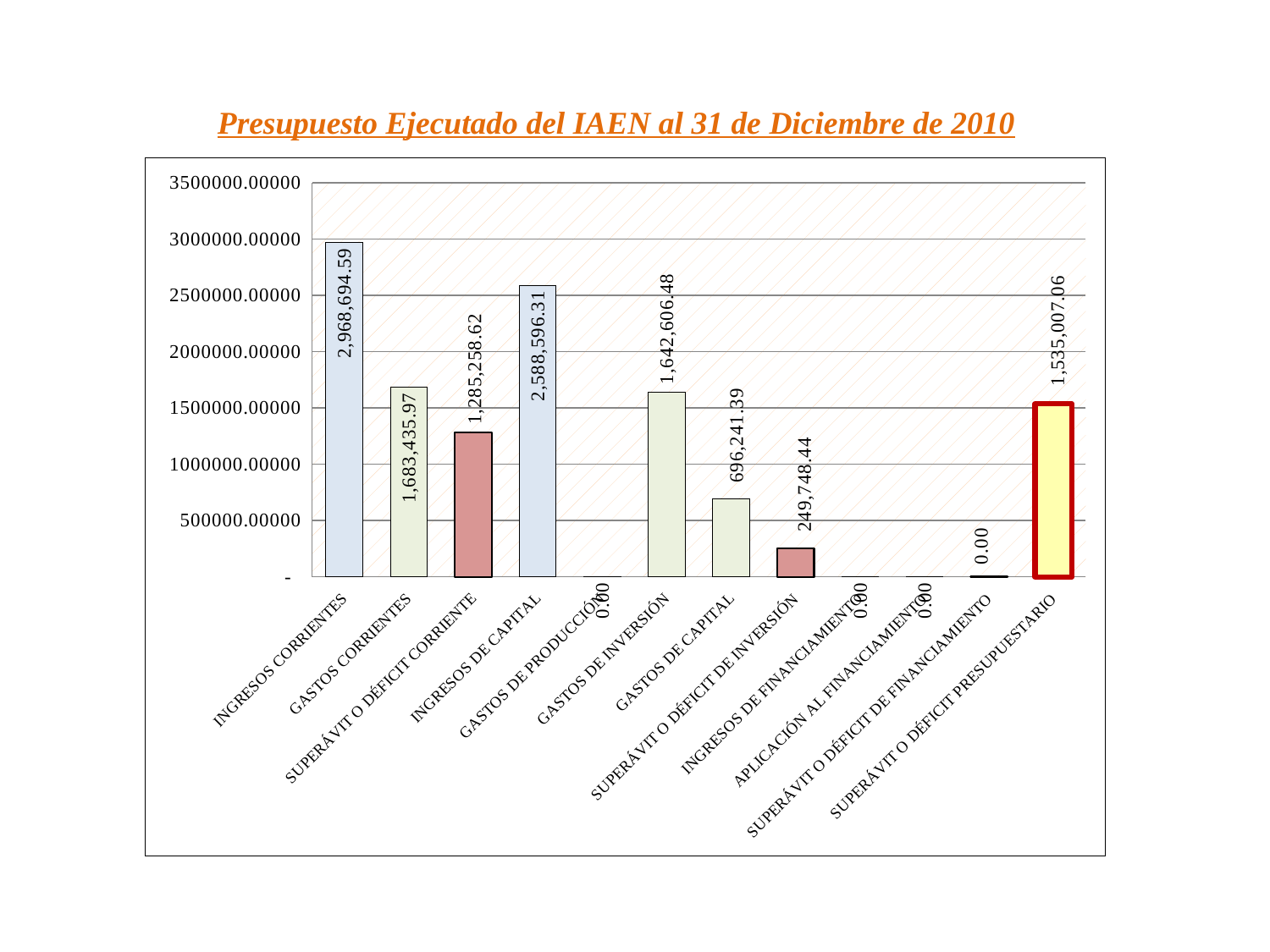
What is the difference between INGRESOS DE CAPITAL and GASTOS DE CAPITAL? 1,892,354.92 Is the value for GASTOS DE CAPITAL greater or less than 1000000? less What is the value for INGRESOS CORRIENTES? 2,968,694.59 Which category has the highest value? INGRESOS CORRIENTES Which is larger, INGRESOS CORRIENTES or INGRESOS DE CAPITAL? INGRESOS CORRIENTES What is the title of the slide? Presupuesto Ejecutado del IAEN al 31 de Diciembre de 2010 How many categories are shown on the x axis? 12 What is the value for SUPERÁVIT O DÉFICIT DE INVERSIÓN? 249,748.44 What is the value for SUPERÁVIT O DÉFICIT PRESUPUESTARIO? 1,535,007.06 What kind of chart is shown on the slide? bar chart What is the value for GASTOS DE CAPITAL? 696,241.39 What is the difference between INGRESOS CORRIENTES and GASTOS CORRIENTES? 1,285,258.62